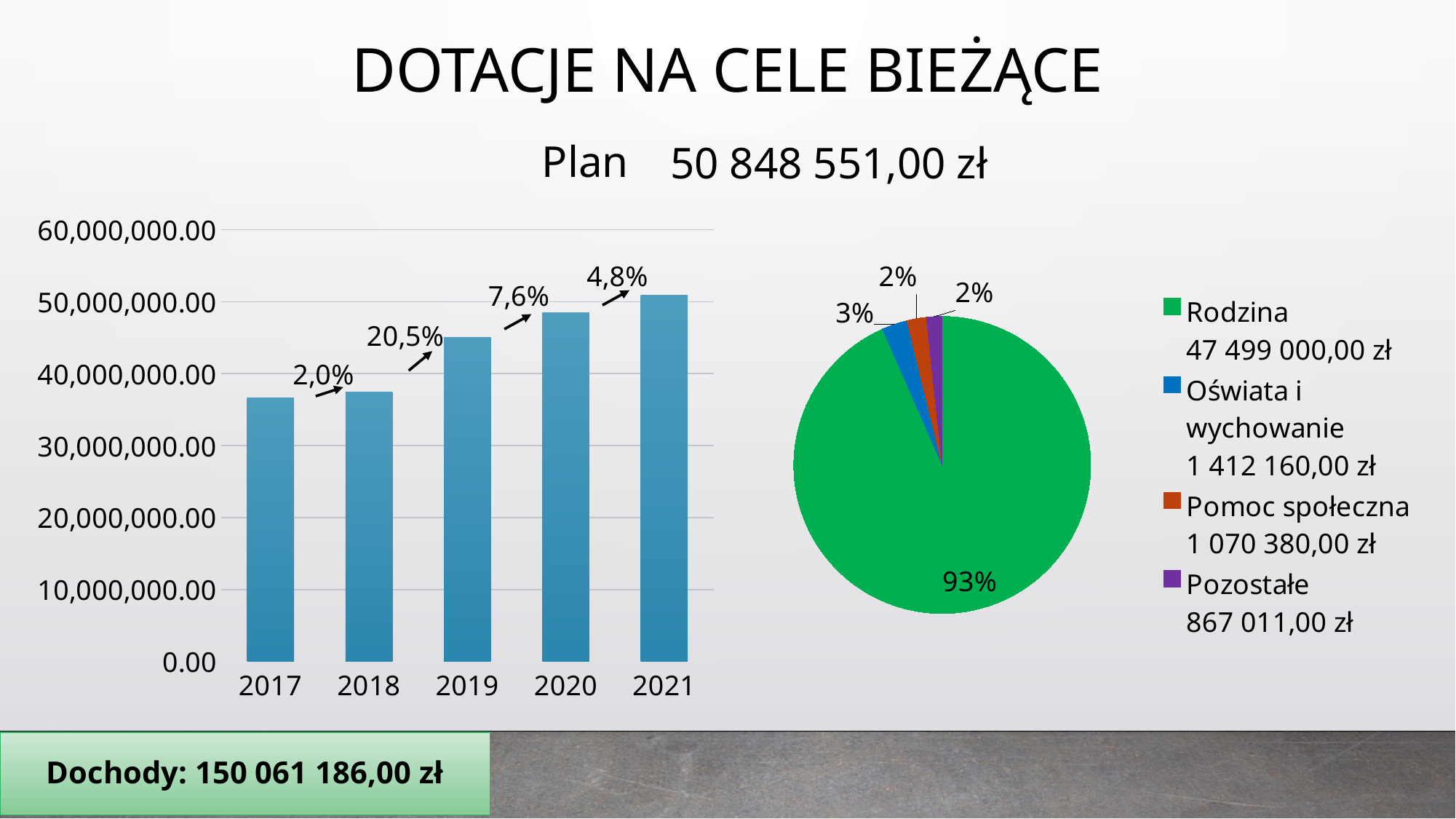
In the bar chart on the left, how many years are shown on the x axis? 5 In the pie chart on the right, what is the difference between the legend values for Oświata i wychowanie and Pomoc społeczna? 341 780,00 zł In the bar chart on the left, is the value for 2019 greater or less than 40,000,000.00? greater In the bar chart on the left, what percentage change is labelled between 2018 and 2019? 20,5% In the pie chart on the right, what is the value shown in the legend for Pomoc społeczna? 1 070 380,00 zł What kind of chart is the chart on the left of the slide? bar chart In the bar chart on the left, is the value for 2017 greater or less than 40,000,000.00? less In the bar chart on the left, which year has the highest bar? 2021 In the bar chart on the left, do the values rise or fall from 2017 to 2021? rise In the bar chart on the left, which year has the lowest bar? 2017 What kind of chart is the chart on the right of the slide? pie chart In the pie chart on the right, what share of the pie does Rodzina have? 93%